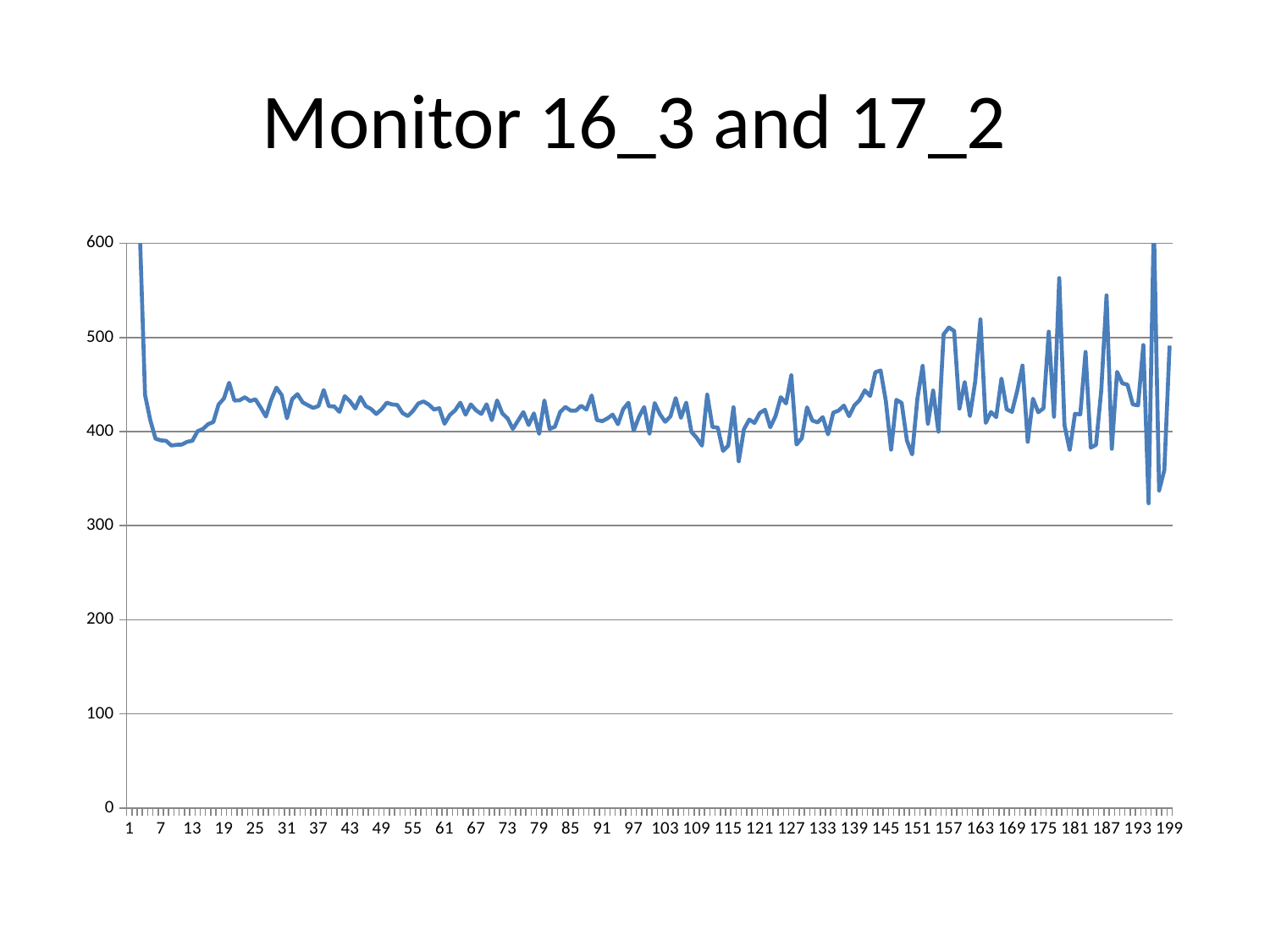
How many labels are printed along the x axis? 34 What is the title of the chart? Monitor 16_3 and 17_2 Is the value at x = 19 greater or less than 400? greater What kind of chart is shown on the slide? line chart Is the value at x = 195 greater or less than 400? less What is the highest value shown on the y axis? 600 Is the value at x = 85 greater or less than 500? less